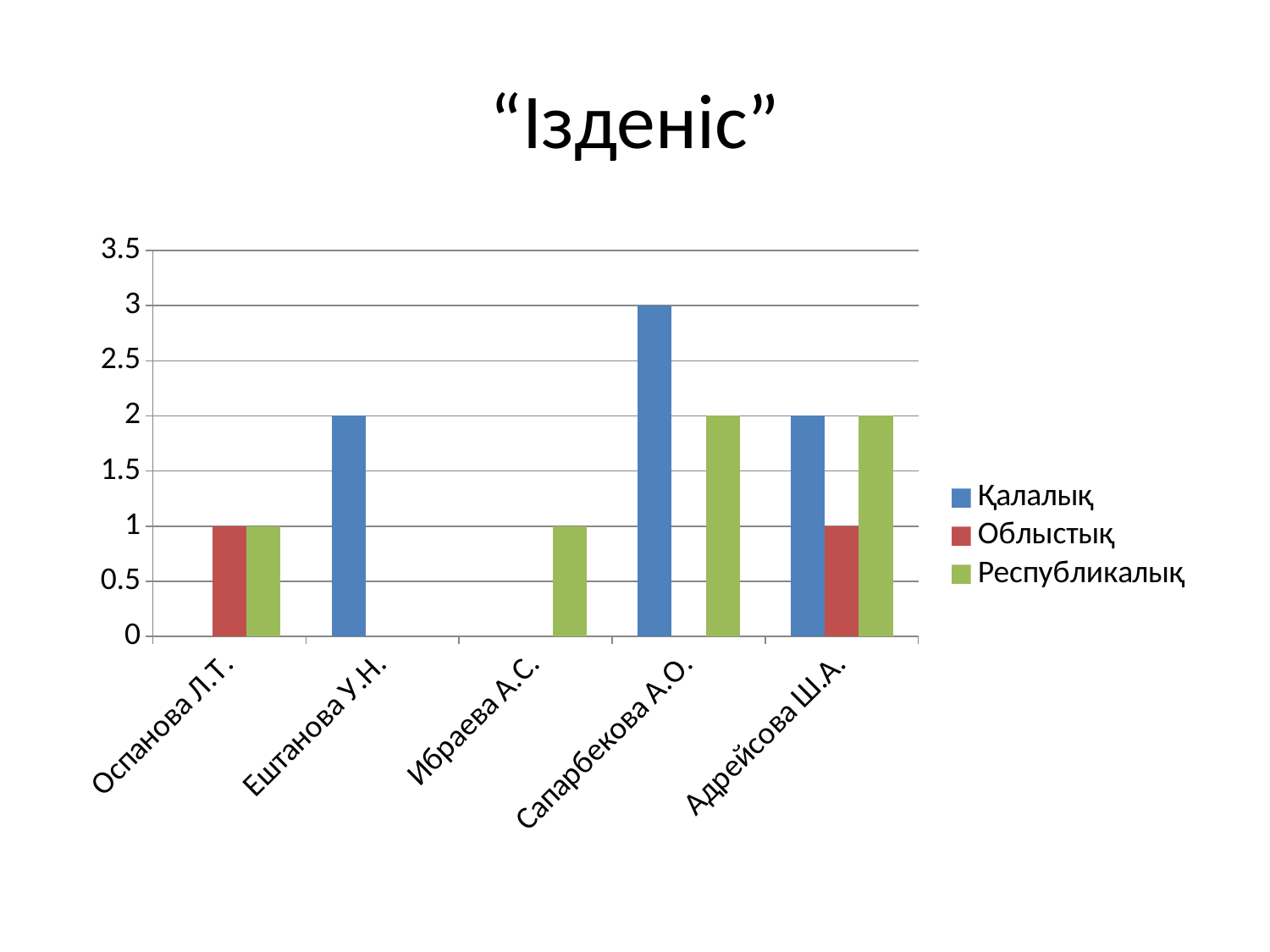
What is the Республикалық value for Адрейсова Ш.А.? 2 What is the Қалалық value for Ештанова У.Н.? 2 Is the Қалалық value for Сапарбекова А.О. greater or less than 2.5? greater How many series does the legend list? 3 Which is larger: the Республикалық value for Ибраева А.С. or the Республикалық value for Сапарбекова А.О.? Сапарбекова А.О. What is the Қалалық value for Сапарбекова А.О.? 3 Which category has the highest Қалалық value? Сапарбекова А.О. What is the title of the chart slide? “Ізденіс” What type of chart is shown on the slide? bar chart What is the difference between the Қалалық value for Сапарбекова А.О. and the Қалалық value for Адрейсова Ш.А.? 1 What is the Облыстық value for Оспанова Л.Т.? 1 How many categories (people) are shown on the x axis? 5